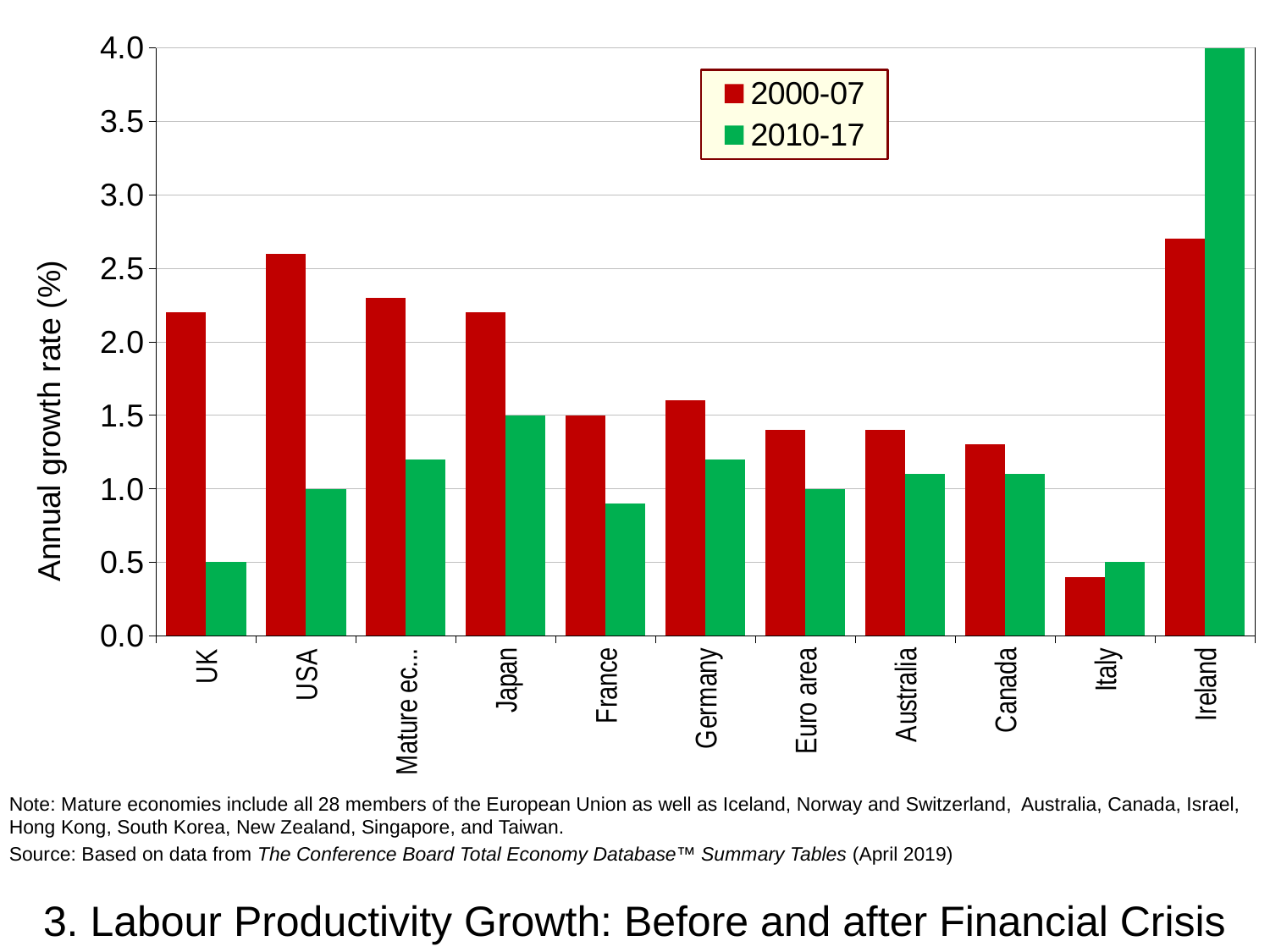
Is the 2010-17 value for France greater or less than 1.0? less What kind of chart is shown on the slide? bar chart Which country or region has the lowest 2000-07 annual growth rate? Italy Which is larger, the 2000-07 value for the USA or the 2000-07 value for the UK? USA Which country or region has the highest 2010-17 annual growth rate? Ireland Is the 2000-07 value for Italy greater or less than 0.5? less What is the label on the y axis? Annual growth rate (%) What is the 2010-17 annual growth rate for the UK? 0.5 Is the 2000-07 value for the USA greater or less than 2.5? greater How many countries or regions are shown on the x axis? 11 How many series does the legend list? 2 What is the 2010-17 annual growth rate for Ireland? 4.0